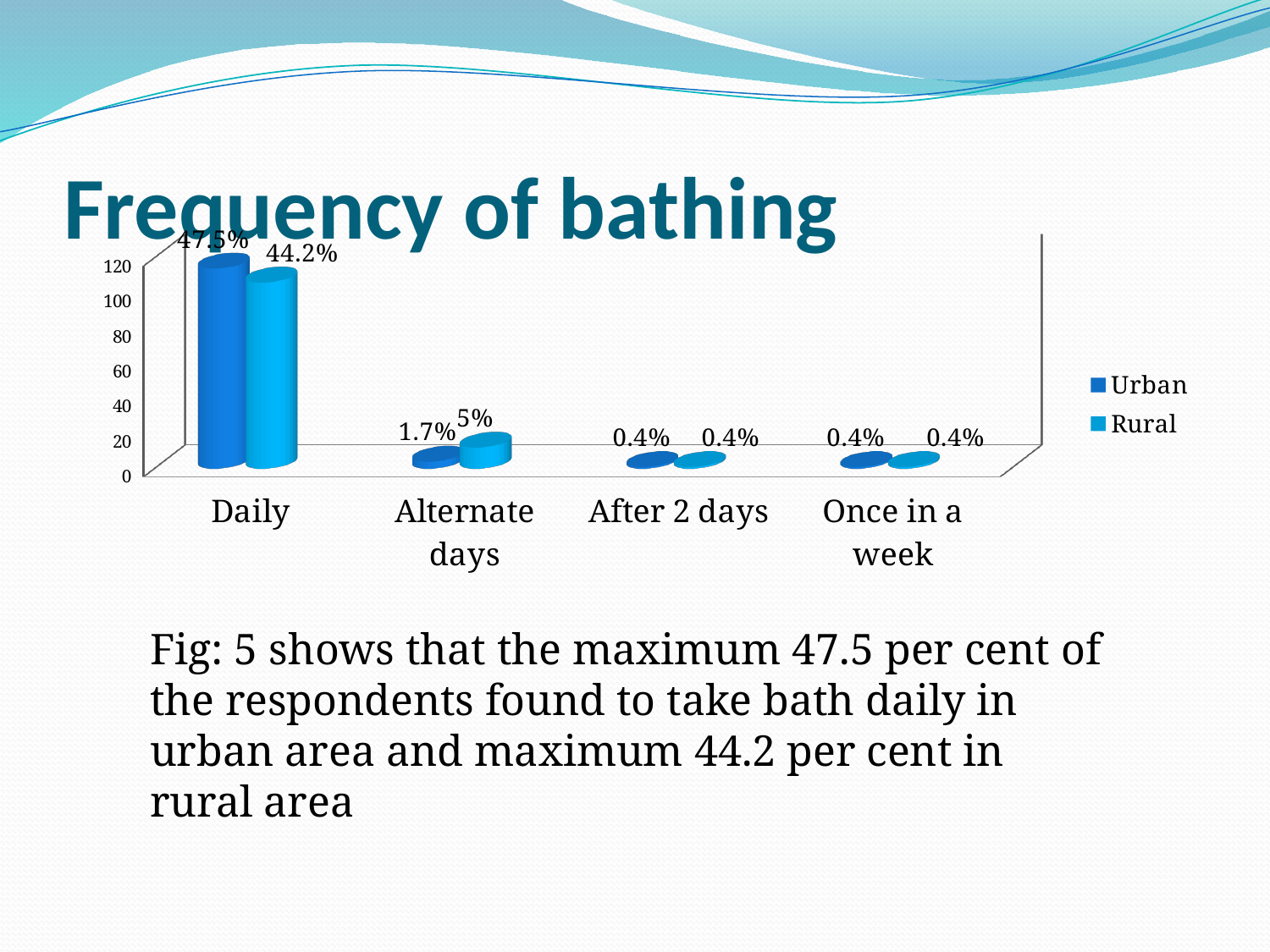
What is the Urban value for Once in a week? 0.4% What is the difference between the Urban and Rural values for Daily? 3.3% How many categories are shown on the x axis? 4 What is the Rural value for Alternate days? 5% Is the Urban bar for Daily greater or less than 100 on the axis? greater How many series does the legend list? 2 Which category has the highest Urban value? Daily What kind of chart is shown on the slide? bar chart What is the Rural value for Daily? 44.2% What is the Urban value for Daily? 47.5% What is the Urban value for Alternate days? 1.7% For Alternate days, which is larger, the Urban or the Rural value? Rural